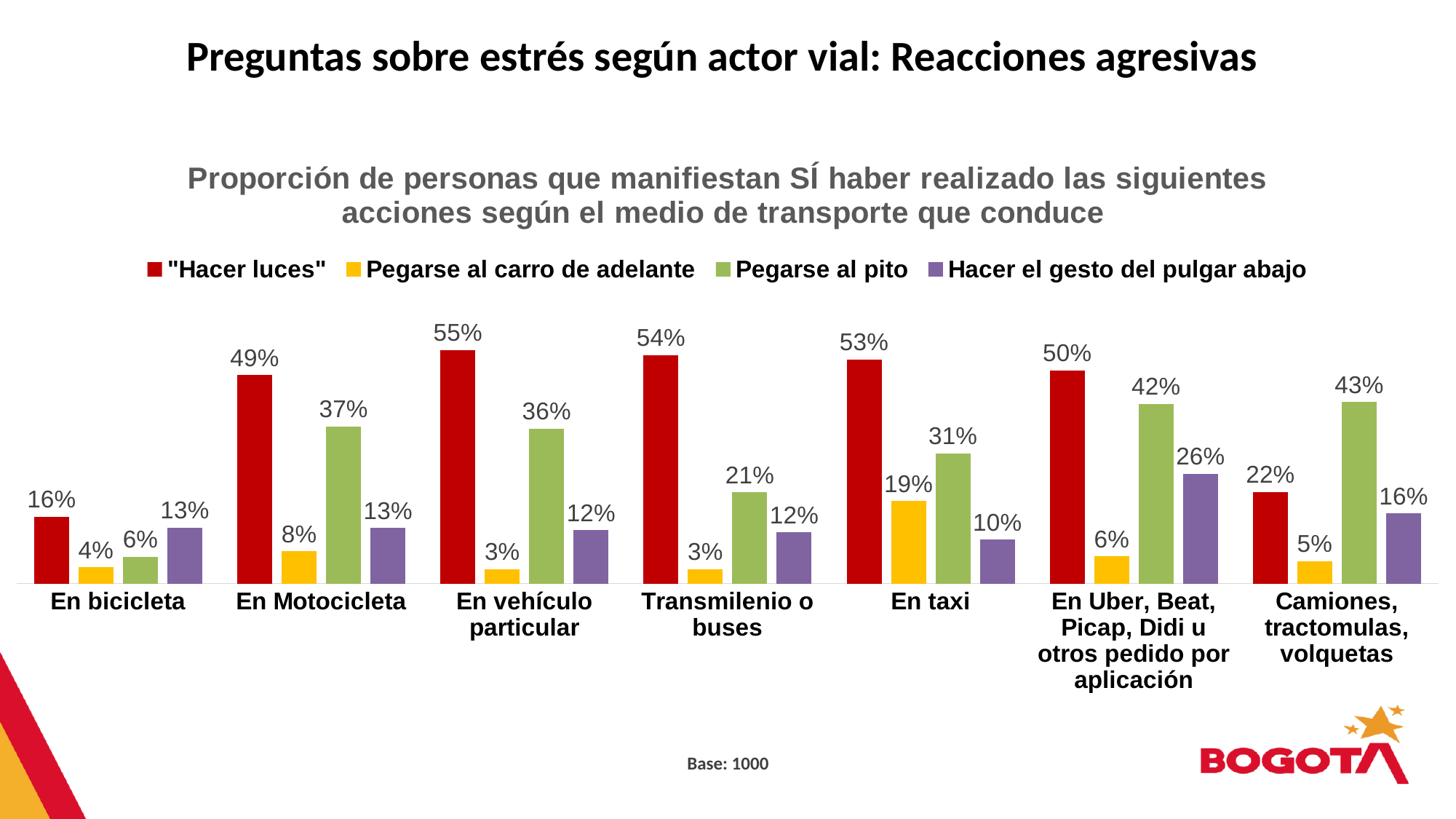
How many series does the legend list? 4 Which is larger: Pegarse al pito for En Motocicleta or for En vehículo particular? En Motocicleta Which category has the highest value for "Hacer luces"? En vehículo particular Which colour represents the series "Hacer luces" in the legend? Red How many transport categories are shown on the x axis? 7 Which category has the lowest value for Pegarse al pito? En bicicleta What is the value of Pegarse al pito for Camiones, tractomulas, volquetas? 43% What is the value of Pegarse al carro de adelante for En taxi? 19% What is the value of Hacer el gesto del pulgar abajo for En Uber, Beat, Picap, Didi u otros pedido por aplicación? 26% What is the value of "Hacer luces" for En vehículo particular? 55% What kind of chart is shown on the slide? Bar chart What is the difference between the "Hacer luces" values for En Motocicleta and En bicicleta? 33%